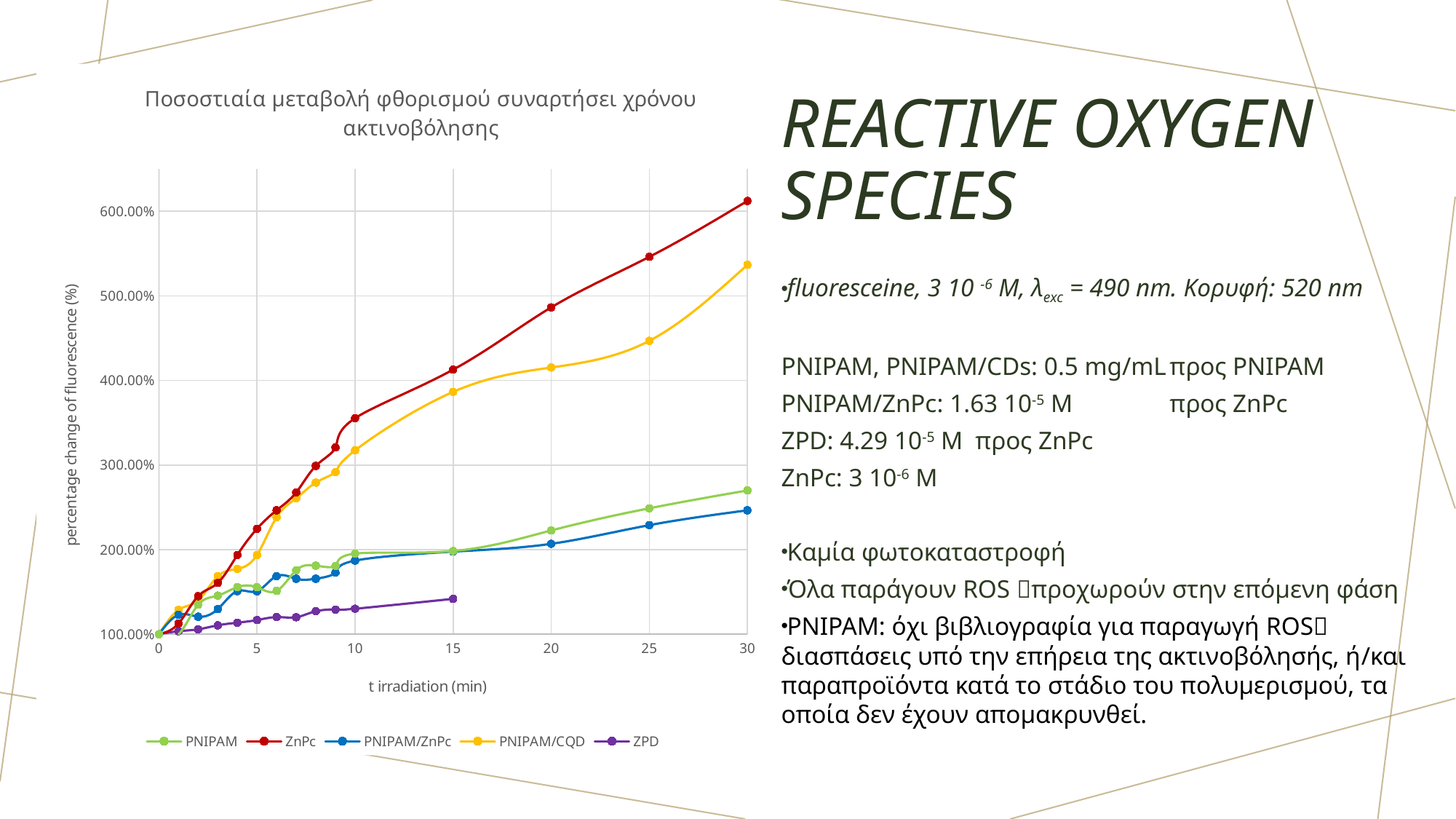
At 30 minutes, which is larger: the value for ZnPc or the value for PNIPAM/CQD? ZnPc Is the value for PNIPAM/ZnPc at 30 minutes greater or less than 200.00%? greater Which series has the highest value at 30 minutes of irradiation? ZnPc Is the value for PNIPAM/CQD at 30 minutes greater or less than 500.00%? greater Which series has the lowest value at 15 minutes of irradiation? ZPD Is the value for ZPD at 15 minutes greater or less than 200.00%? less How many series does the chart legend list? 5 What kind of chart is shown on the slide? line chart What is the label of the x axis of the chart? t irradiation (min) Do the values for ZnPc rise or fall as irradiation time increases? rise